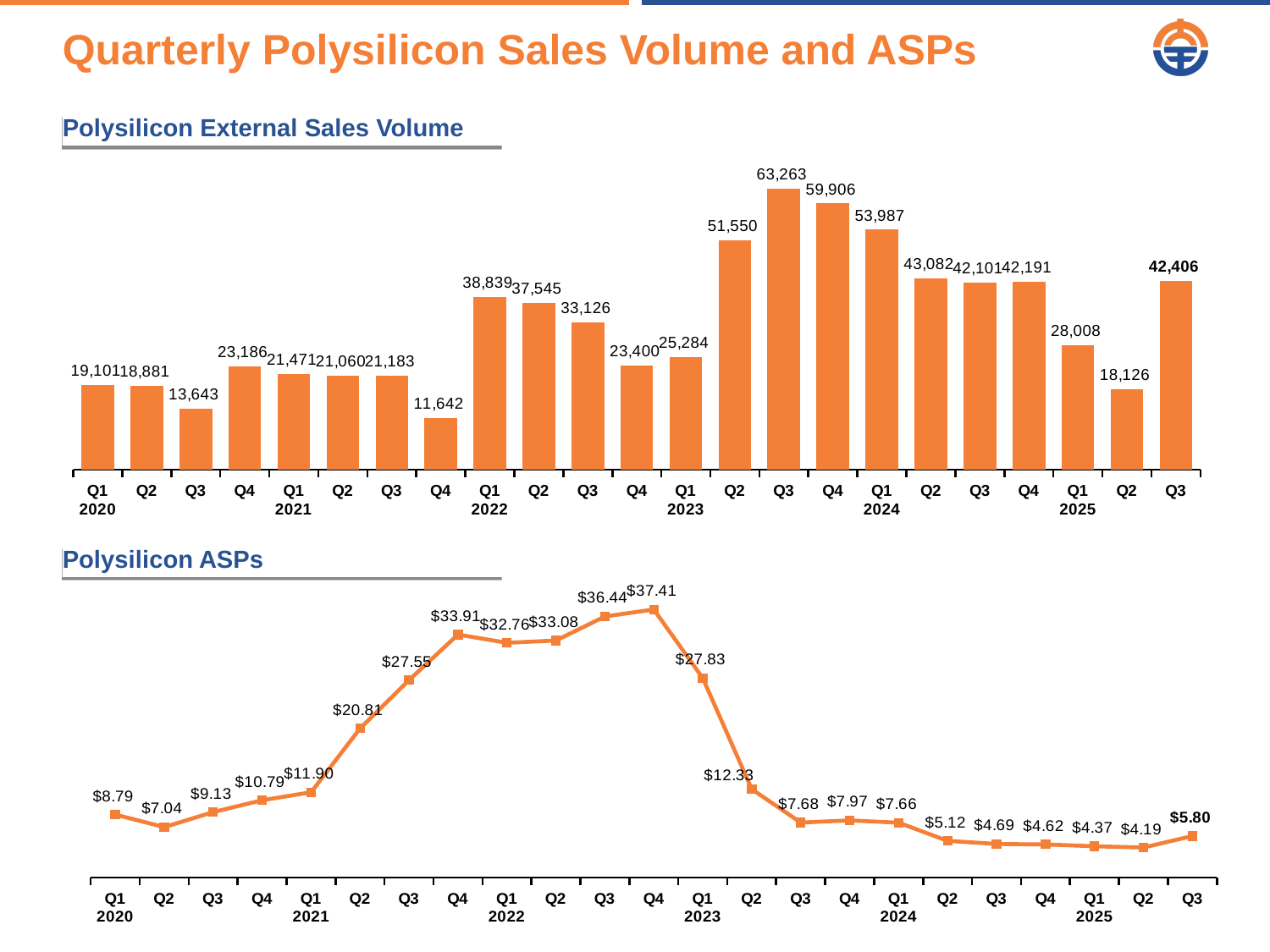
In the Polysilicon ASPs chart, what is the difference between Q1 2023 and Q2 2023? $15.50 How many bars are in the Polysilicon External Sales Volume chart? 23 In the Polysilicon External Sales Volume chart, what is the difference between Q3 2023 and Q4 2023? 3,357 In the Polysilicon External Sales Volume chart, which is larger, Q1 2022 or Q2 2022? Q1 2022 In the Polysilicon External Sales Volume chart, which quarter has the lowest sales volume? Q4 2021 In the Polysilicon ASPs chart, do values rise or fall from Q4 2022 to Q2 2025? Fall In the Polysilicon ASPs chart, what is the value for Q4 2022? $37.41 What kind of chart is the Polysilicon ASPs chart? Line chart What kind of chart is the Polysilicon External Sales Volume chart? Bar chart In the Polysilicon External Sales Volume chart, what is the value for Q3 2025? 42,406 In the Polysilicon ASPs chart, which quarter has the lowest ASP? Q2 2025 In the Polysilicon External Sales Volume chart, which quarter has the highest sales volume? Q3 2023